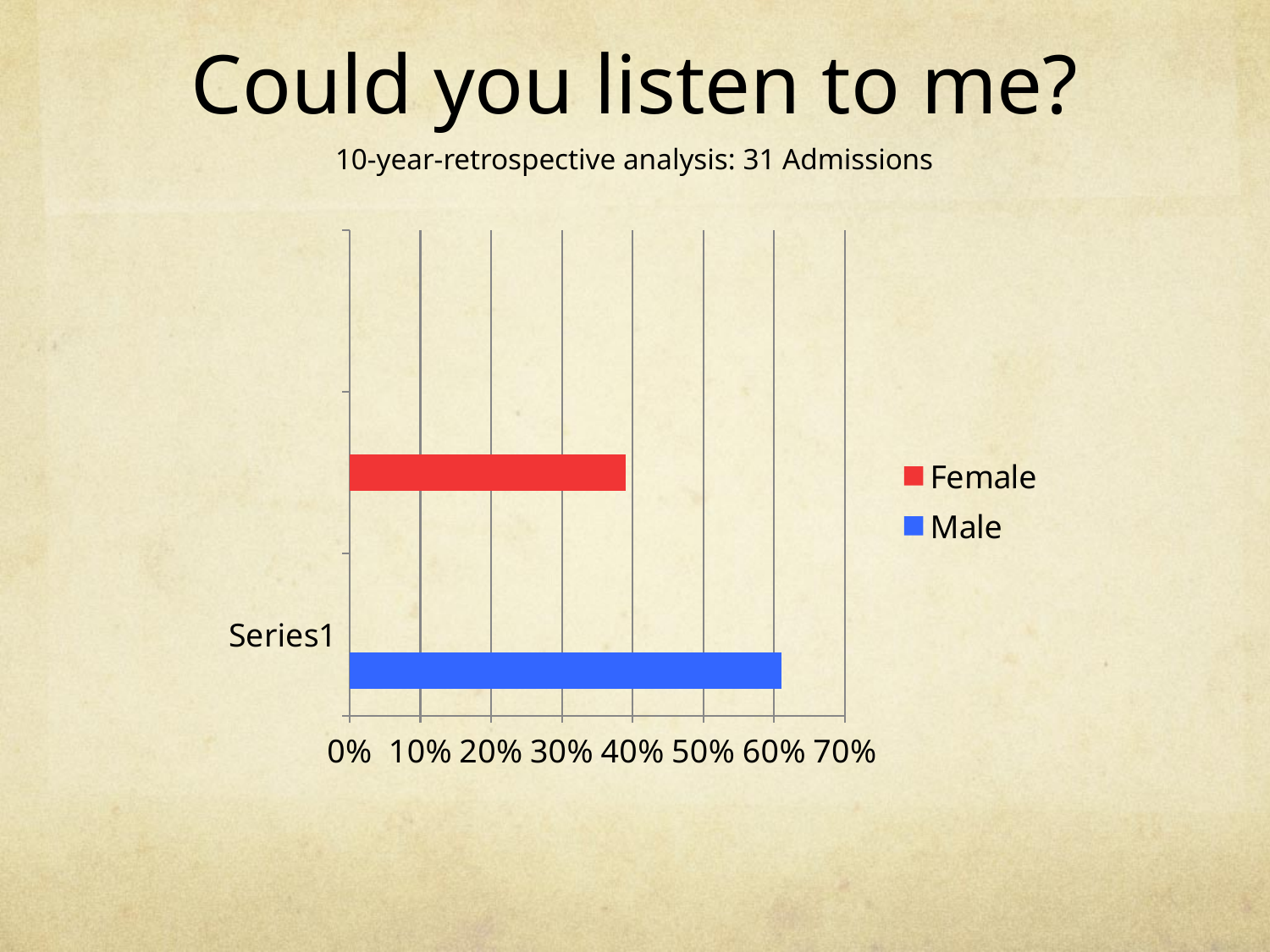
Is the value for Male greater or less than 50%? greater Is the value for Female greater or less than 30%? greater How many categories are shown on the vertical axis? 1 Is the value for Female greater or less than 50%? less What colour is the bar for Female? red Which series has the lowest value? Female What kind of chart is shown on the slide? bar chart How many series does the legend list? 2 What is the subtitle shown above the chart? 10-year-retrospective analysis: 31 Admissions Which series has the longer bar, Female or Male? Male Which series has the highest value? Male